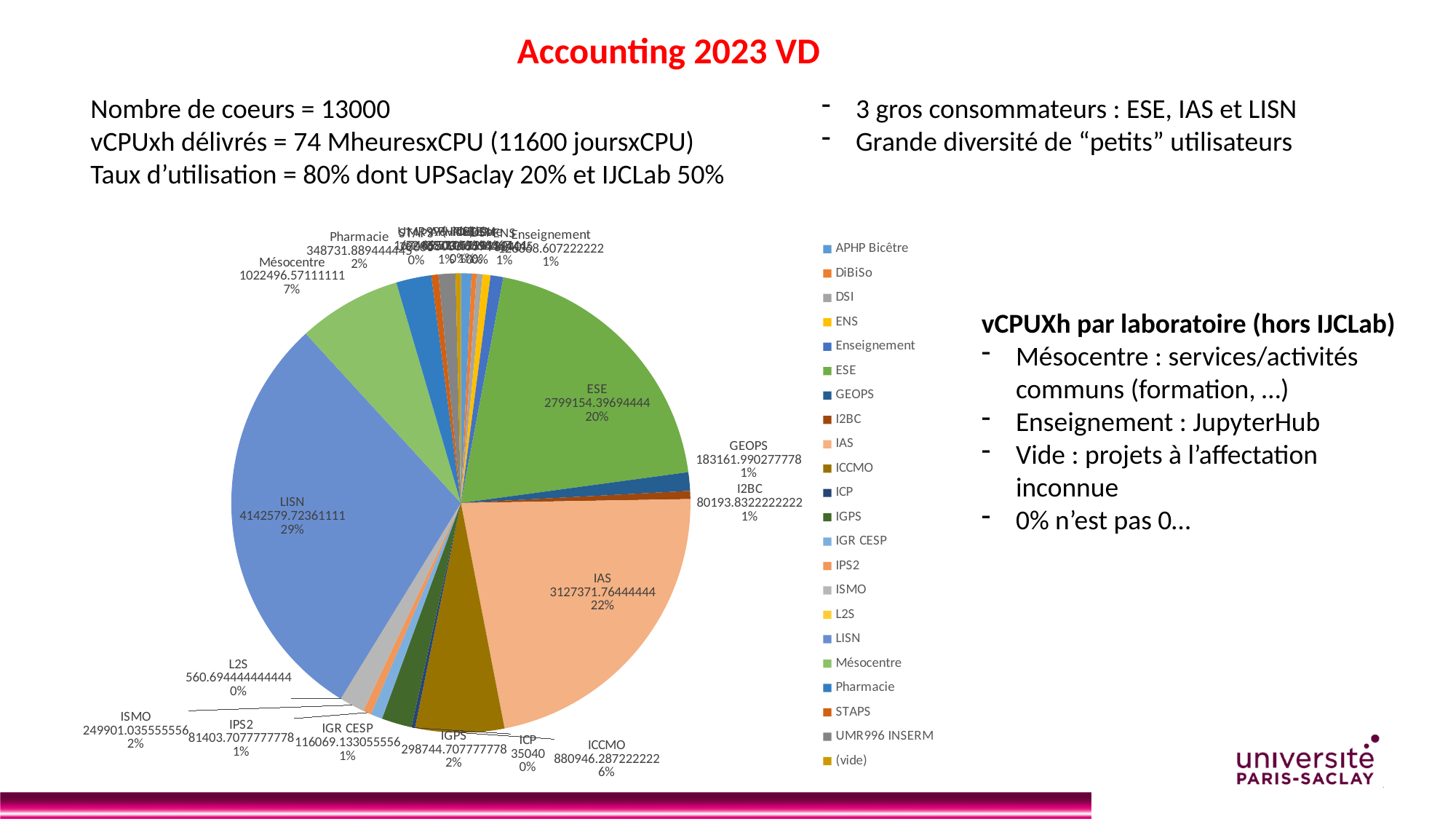
What is the value shown for ICP in the pie chart? 35040 Which laboratory has the largest slice of the pie chart? LISN Which slice is larger, ESE or ICCMO? ESE What share of the pie does Mésocentre account for? 7% Which slice is larger, LISN or IAS? LISN How many entries does the legend of the pie chart list? 22 What is the value shown for GEOPS in the pie chart? 183161.990277778 What share of the pie does ESE account for? 20% What share of the pie does IAS account for? 22% What kind of chart is shown on the slide? pie chart